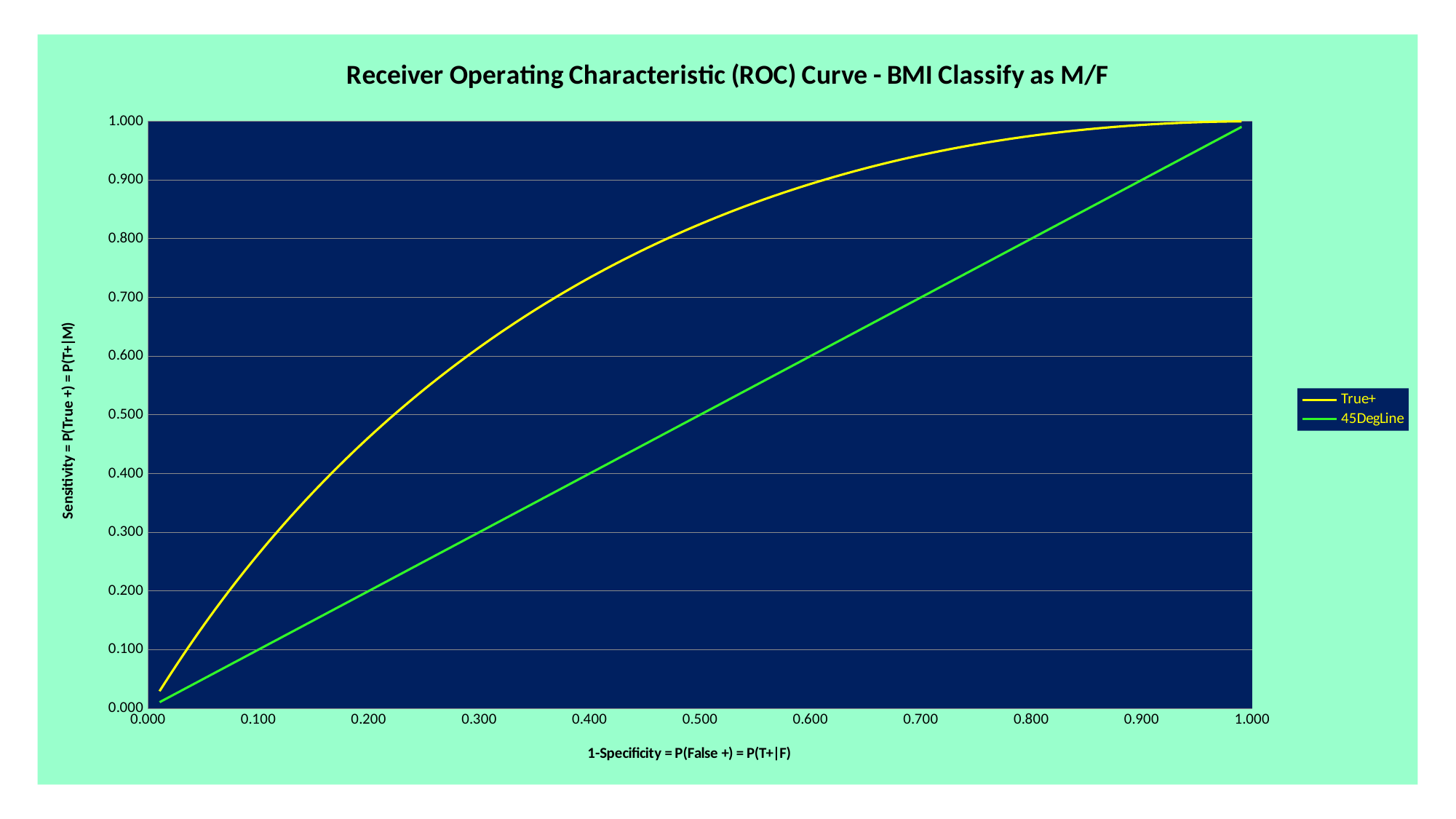
At an x value of 0.500, is the True+ value greater or less than 0.700? greater How many series does the legend list? 2 What colour is the True+ line? yellow What is the title of the chart? Receiver Operating Characteristic (ROC) Curve - BMI Classify as M/F At an x value of 0.600, which series is lower, True+ or 45DegLine? 45DegLine At an x value of 0.200, is the True+ value greater or less than 0.400? greater At an x value of 0.300, which series has the higher value, True+ or 45DegLine? True+ What kind of chart is shown on the slide? line chart Does the True+ line rise or fall as the x-axis value increases? rise Does the 45DegLine series rise or fall along the x axis? rise At an x value of 0.800, is the 45DegLine value greater or less than 0.900? less